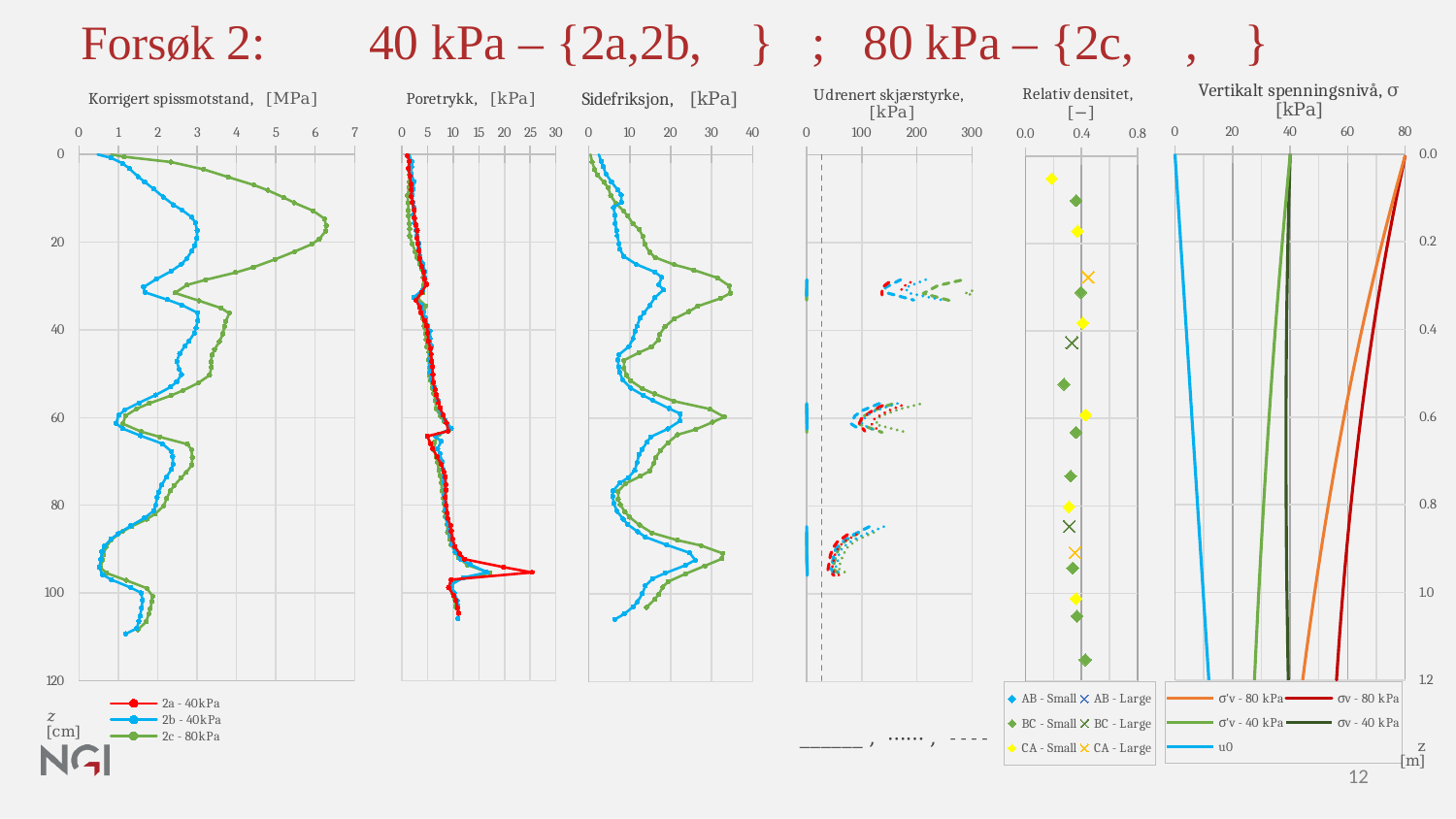
In the 'Vertikalt spenningsnivå, σ [kPa]' chart, does the u0 series increase or decrease with depth z? increase How many series does the legend under the 'Korrigert spissmotstand' chart list? 3 In the 'Vertikalt spenningsnivå, σ [kPa]' chart, what is the value of the σv - 80 kPa series at z = 0.0 m? 80 In the 'Poretrykk, [kPa]' chart, is the peak value of the 2a - 40kPa series near z = 95 cm greater or less than 20 kPa? greater In the 'Korrigert spissmotstand' chart, is the peak value of the 2c - 80kPa series near z = 20 cm greater or less than 5 MPa? greater In the 'Vertikalt spenningsnivå, σ [kPa]' chart, what is the value of the σv - 40 kPa series at z = 0.0 m? 40 In the 'Sidefriksjon, [kPa]' chart, is the peak value of the 2c - 80kPa series near z = 30 cm greater or less than 30 kPa? greater How many series does the legend under the 'Relativ densitet' chart list? 6 What kind of chart is the 'Korrigert spissmotstand, [MPa]' chart? line chart How many charts are shown on the slide? 6 How many series does the legend under the 'Vertikalt spenningsnivå, σ [kPa]' chart list? 5 In the 'Korrigert spissmotstand' chart, which series reaches the highest value? 2c - 80kPa